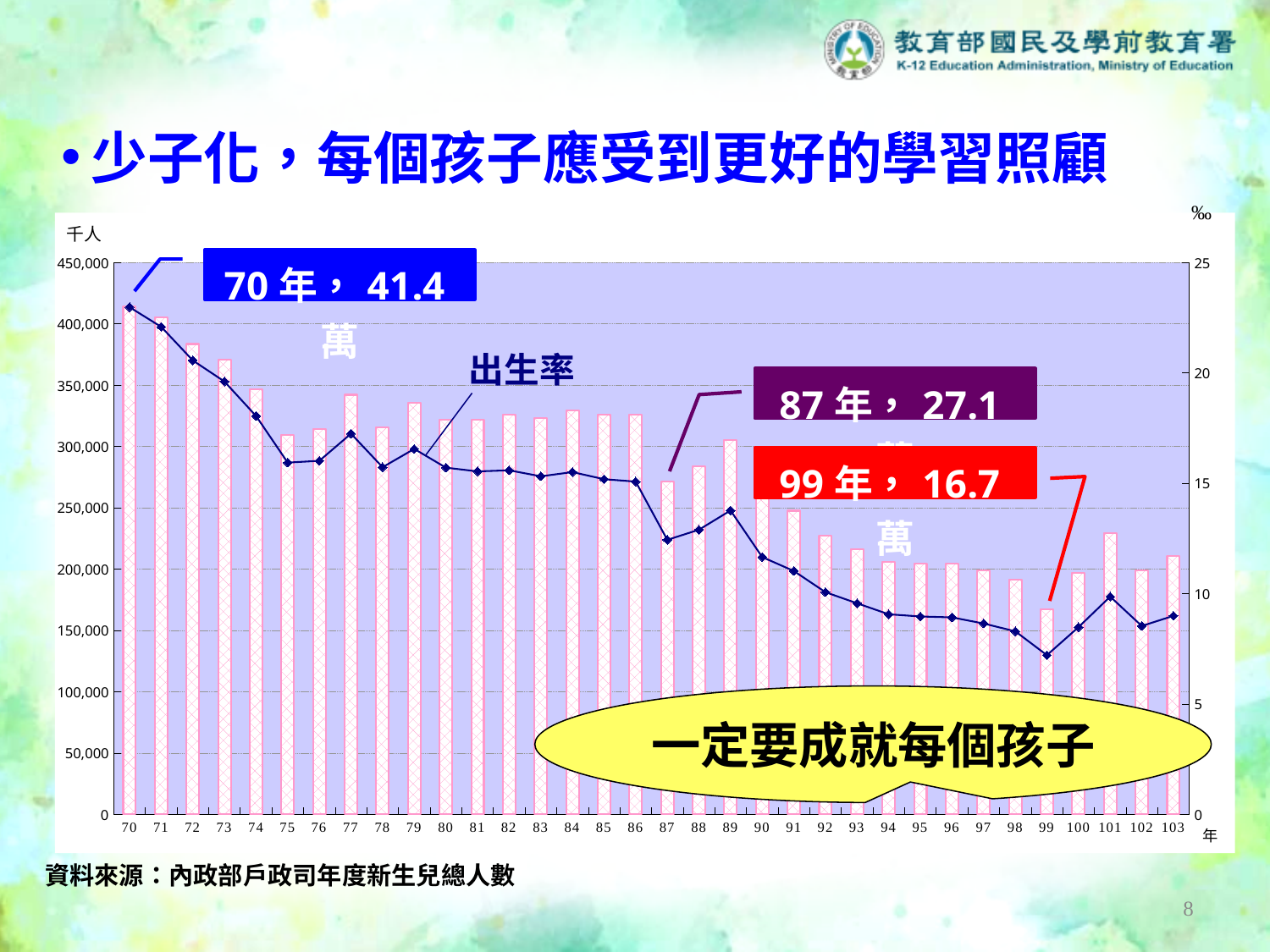
Is the bar value for year 99 greater or less than 200,000? less Is the bar value for year 70 greater or less than 400,000? greater What kind of chart is shown on the slide? A combination bar and line chart How many years are shown along the x axis? 34 According to the callout, what was the number of newborns in year 70? 41.4萬 What is the name of the line series plotted on the chart? 出生率 Which year has the tallest bar (highest number of newborns)? 70 What is the difference between the newborn counts labelled for year 70 and year 99? 24.7萬 Which year has the larger newborn count, 87 or 99? 87 Which year has the shortest bar (lowest number of newborns)? 99 According to the callout, what was the number of newborns in year 87? 27.1萬 According to the callout, what was the number of newborns in year 99? 16.7萬